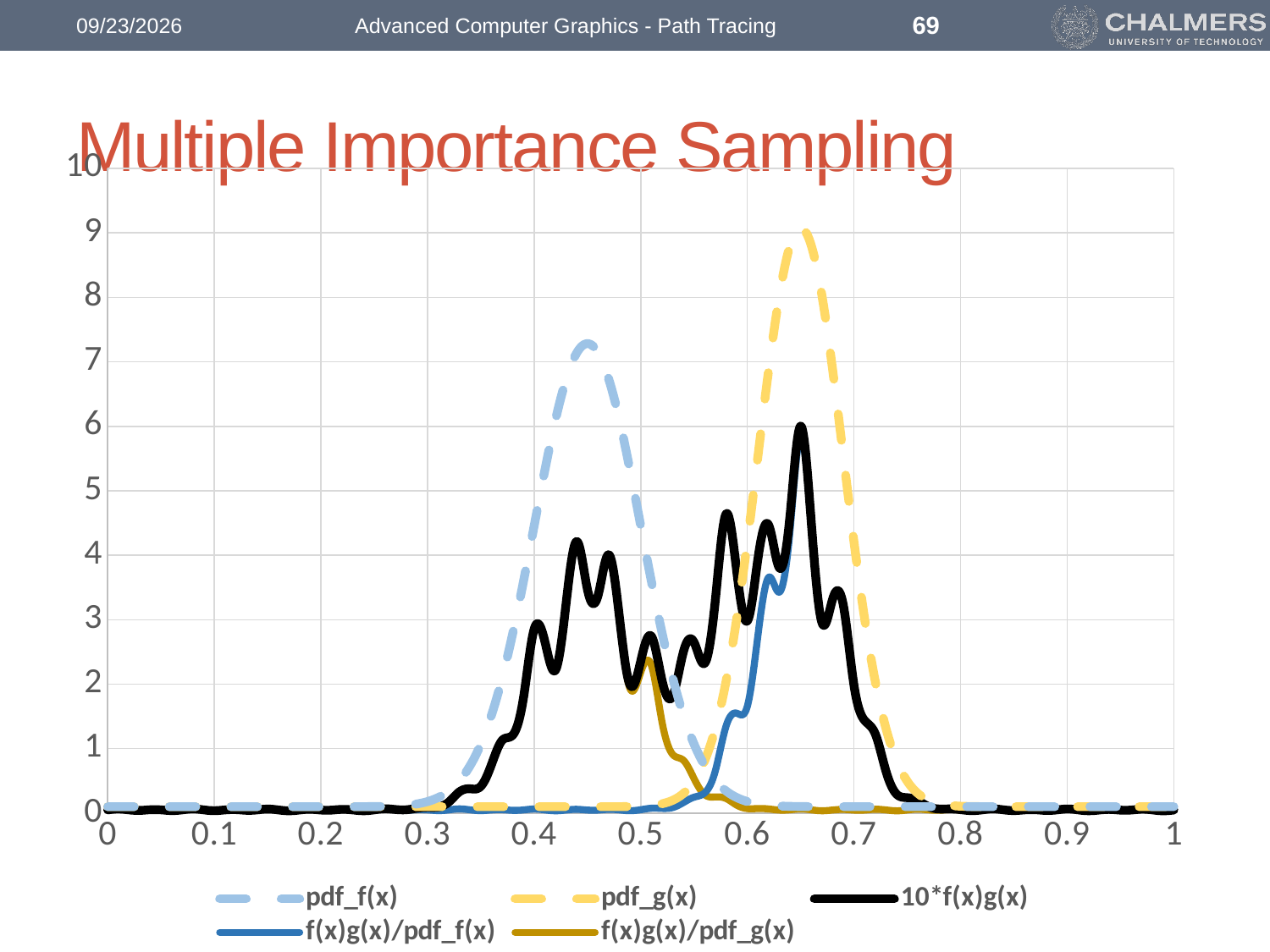
Which series has the highest peak of all the series plotted? pdf_g(x) Is the peak value of 10*f(x)g(x) greater or less than 5? greater Is the value of pdf_g(x) at x = 0.45 greater or less than 1? less How many series does the legend list? 5 Is the value of f(x)g(x)/pdf_g(x) at x = 0.5 greater or less than 3? less What is the highest value shown on the vertical axis? 10 What kind of chart is shown on the slide? line chart Which series is drawn as a solid black line? 10*f(x)g(x) Which series reaches a higher peak, pdf_f(x) or pdf_g(x)? pdf_g(x)